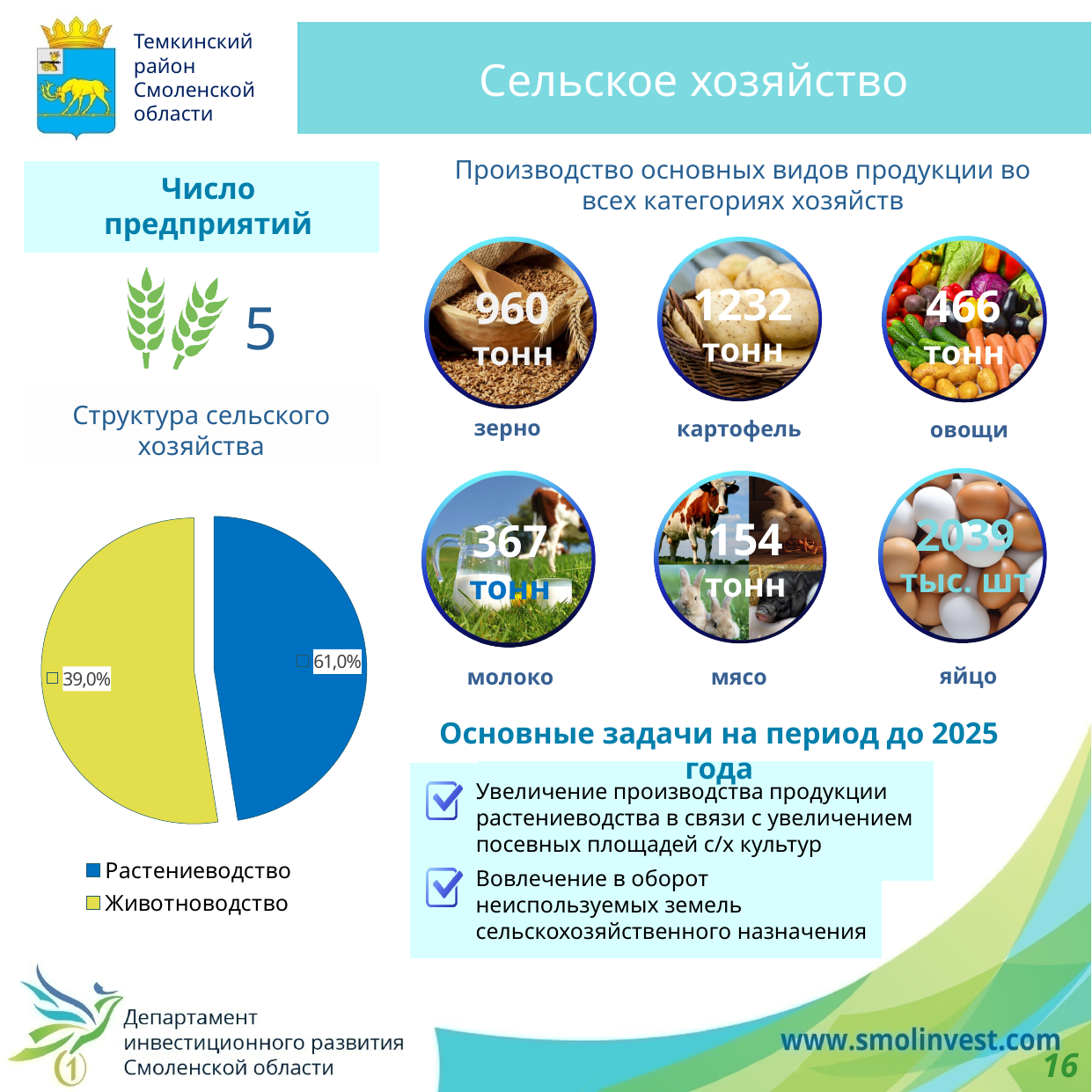
What share of the pie chart does Животноводство have? 39,0% Which slice of the pie chart is the smallest? Животноводство In the pie chart, which is larger: Растениеводство or Животноводство? Растениеводство Which slice of the pie chart is the largest? Растениеводство What share of the pie chart does Растениеводство have? 61,0% What is the title shown above the pie chart? Структура сельского хозяйства What kind of chart is shown under "Структура сельского хозяйства"? pie chart Is the share of Животноводство in the pie chart greater or less than 50%? less By how many percentage points does Растениеводство exceed Животноводство in the pie chart? 22,0 How many slices does the pie chart have? 2 How many entries does the legend of the pie chart list? 2 What colour is the Растениеводство slice in the pie chart? blue